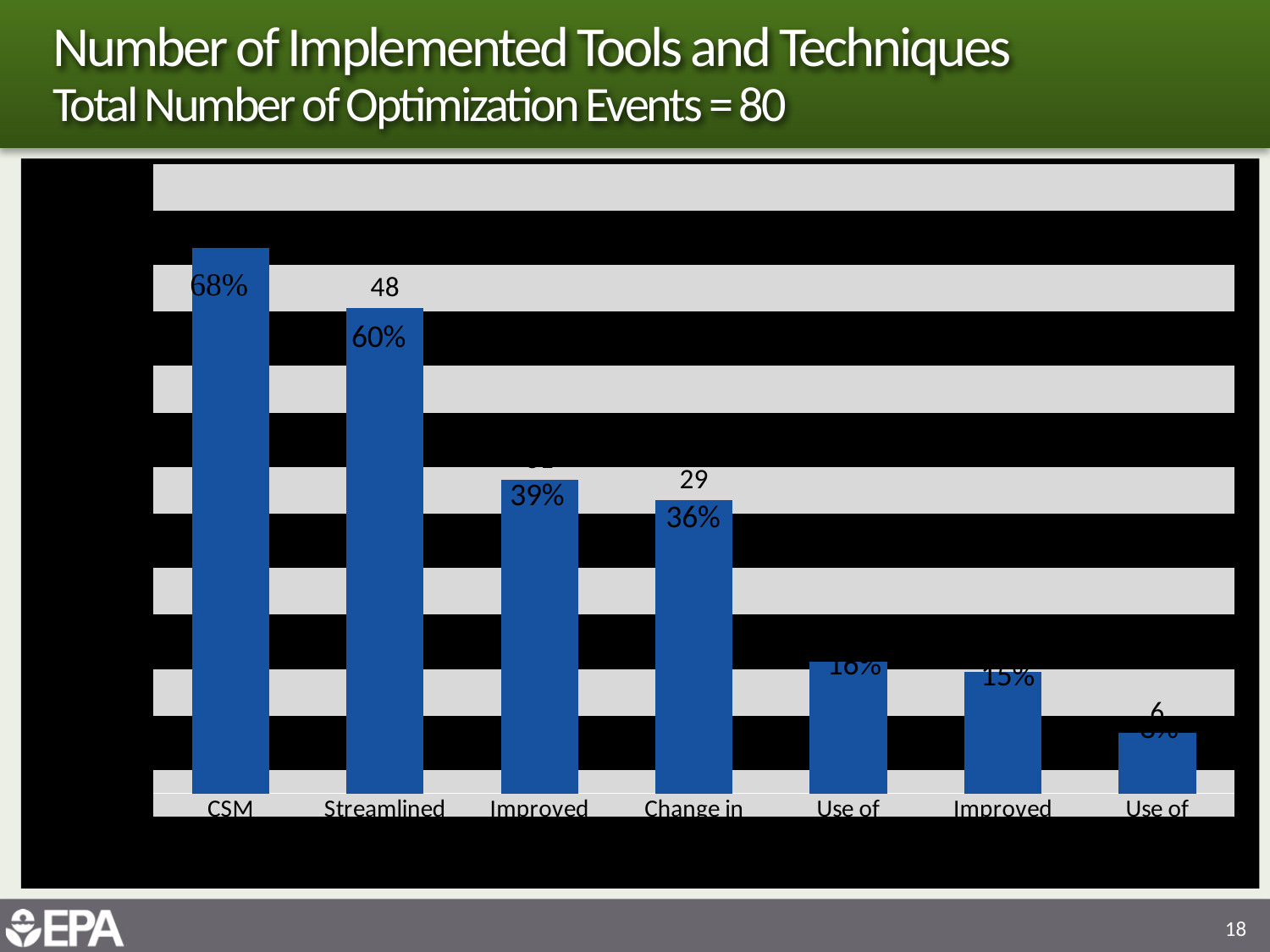
What count is shown above the rightmost (shortest) bar? 6 Which category has the tallest bar? CSM What percentage is shown on the third bar from the left? 39% What is the difference between the counts for Streamlined and 'Change in'? 19 What percentage is shown on the CSM bar? 68% What kind of chart is shown on the slide? bar chart What count is shown above the 'Change in' bar? 29 How many bars are plotted in the chart? 7 What percentage is shown on the Streamlined bar? 60% Which has a higher count, Streamlined or 'Change in'? Streamlined What count is shown above the Streamlined bar? 48 What percentage is shown on the 'Change in' bar? 36%